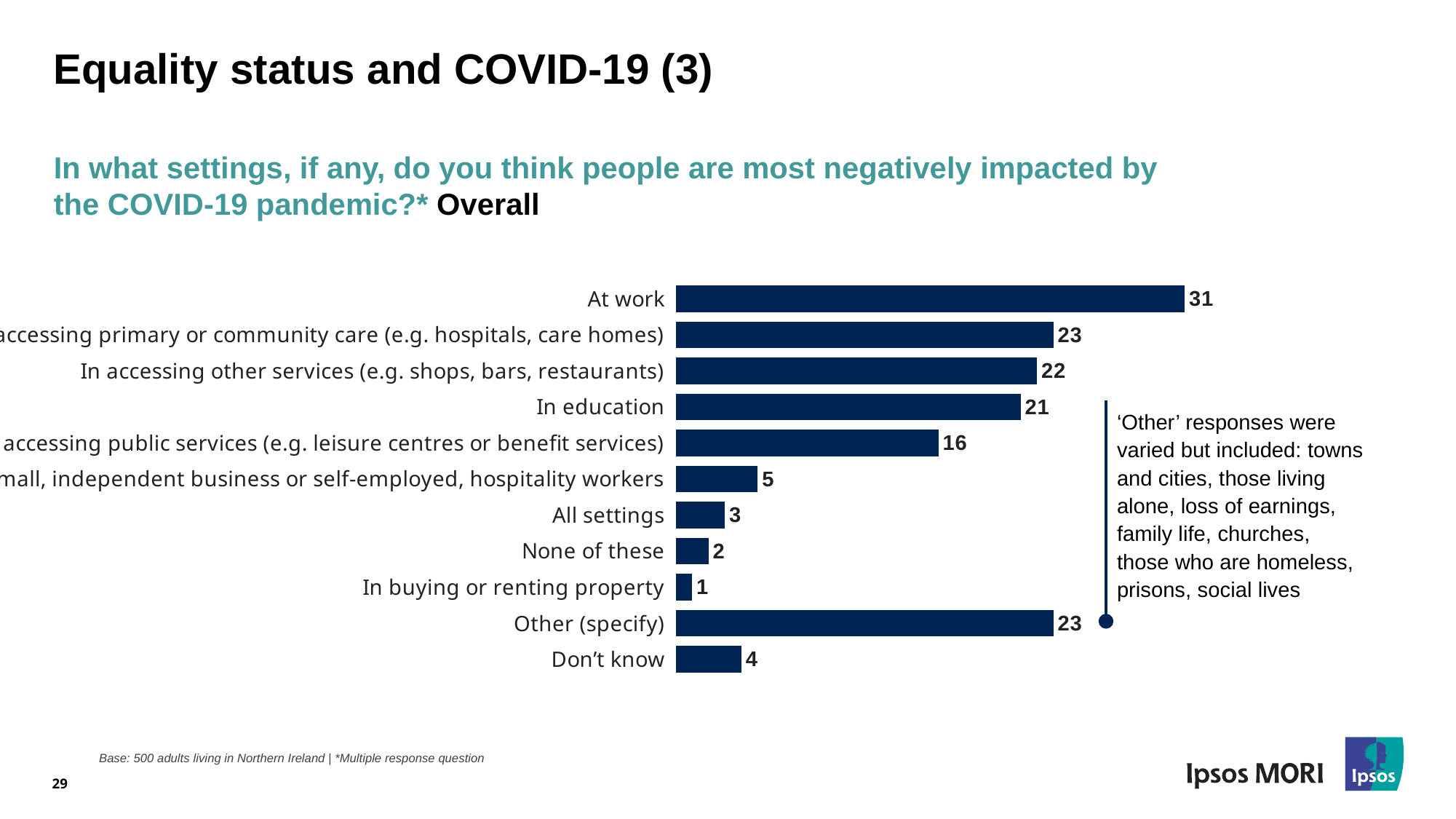
What is the difference between the values for "Other (specify)" and "Don't know"? 19 What is the value for "In education"? 21 Which is larger, the value for "All settings" or the value for "None of these"? All settings Which category has the lowest value? In buying or renting property What kind of chart is shown on the slide? bar chart What is the value for "At work"? 31 What is the difference between the values for "At work" and "In education"? 10 Which category has the highest value? At work What is the value for "Other (specify)"? 23 What is the value for "In accessing other services (e.g. shops, bars, restaurants)"? 22 How many categories are plotted in the chart? 11 What is the value for "Don't know"? 4